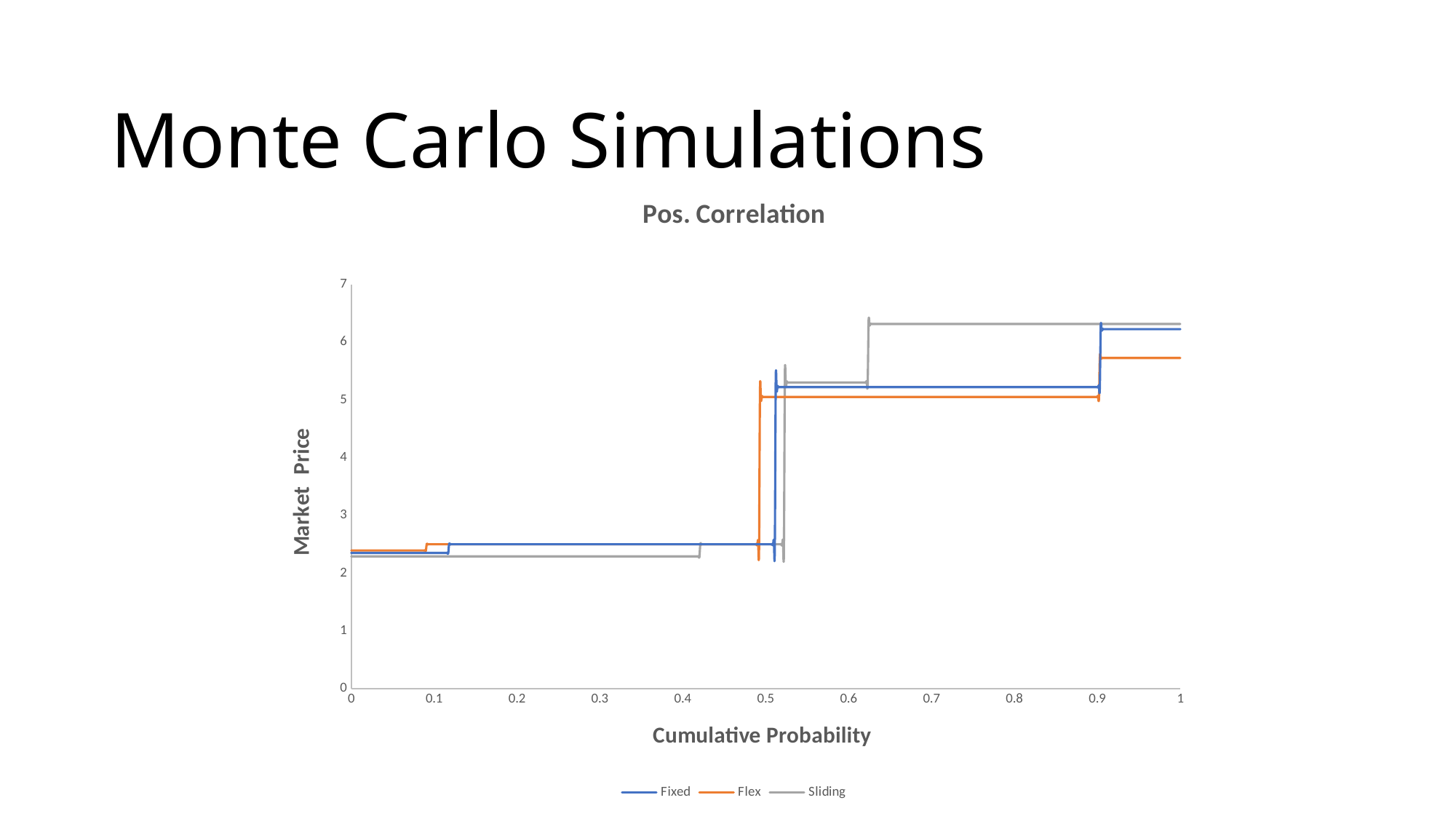
Do the Market Price values generally rise or fall as Cumulative Probability increases? Rise At a cumulative probability of 0.95, is the value for Flex greater or less than 5? greater How many series does the legend list? 3 What kind of chart is shown on the slide? Line chart At a cumulative probability of 0.95, which series has the lowest Market Price? Flex At a cumulative probability of 0.8, which is larger, the value for Sliding or the value for Flex? Sliding At a cumulative probability of 0.8, is the value for Sliding greater or less than 6? greater What is the label of the x axis? Cumulative Probability At a cumulative probability of 0.8, which series has the highest Market Price? Sliding What is the title of the chart? Pos. Correlation At a cumulative probability of 0.95, is the value for Flex greater or less than 6? less